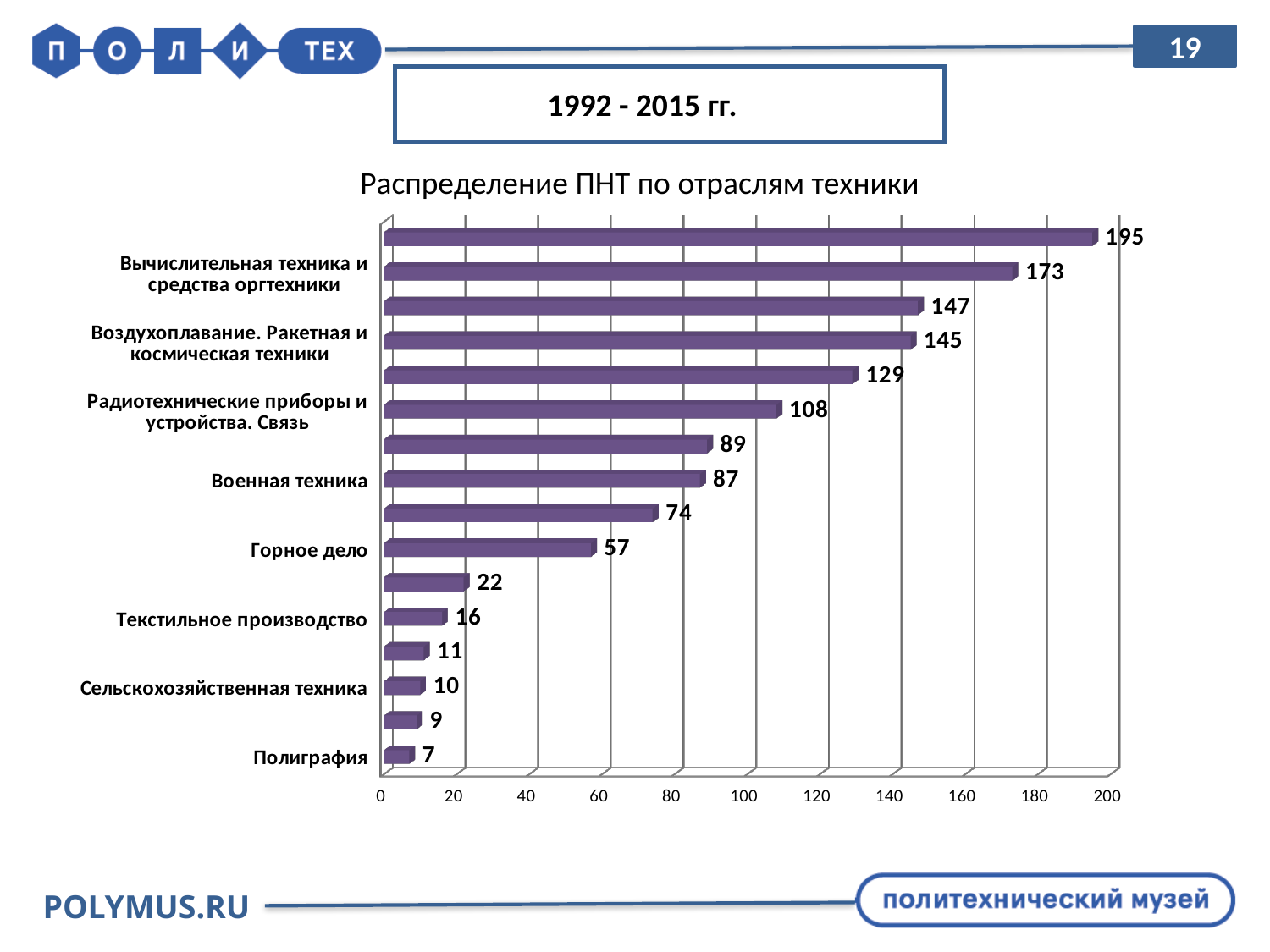
What is the title of the chart? Распределение ПНТ по отраслям техники Which is larger, the value for Текстильное производство or the value for Сельскохозяйственная техника? Текстильное производство What is the value for Военная техника? 87 What is the difference between the values for Радиотехнические приборы и устройства. Связь and Горное дело? 51 What is the largest value shown on the chart? 195 What is the value for Полиграфия? 7 How many bars are plotted on the chart? 16 Which labelled category has the lowest value? Полиграфия What is the value for Вычислительная техника и средства оргтехники? 173 Is the value for Горное дело greater or less than 60? less What kind of chart is shown on the slide? bar chart What is the value for Воздухоплавание. Ракетная и космическая техники? 145